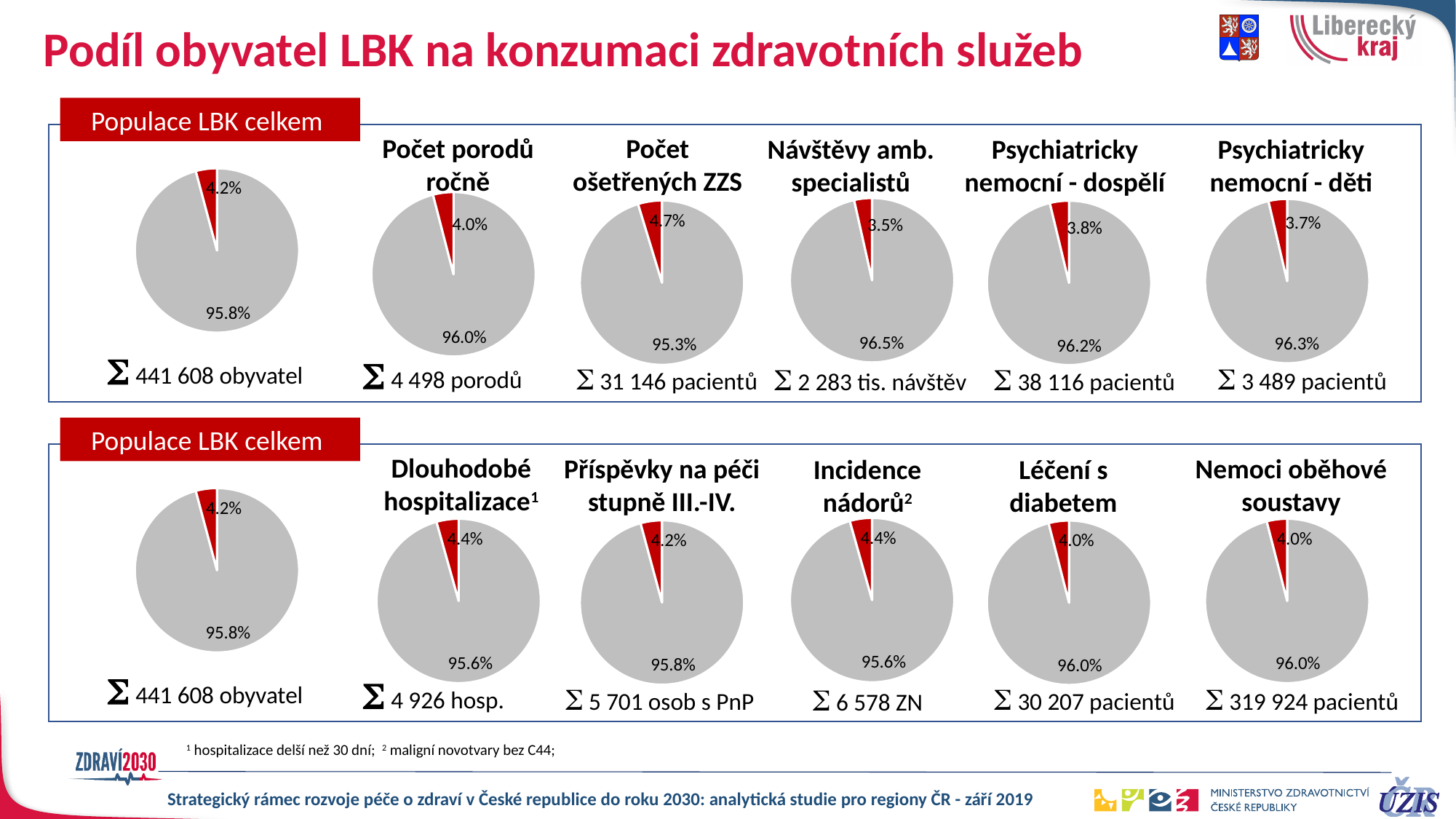
In the pie chart titled "Dlouhodobé hospitalizace", what percentage does the red slice represent? 4.4% Among the pie charts in the top row, which chart has the largest red slice? Počet ošetřených ZZS What colour is the smaller slice in the pie chart titled "Příspěvky na péči stupně III.-IV."? red In the pie chart titled "Počet ošetřených ZZS", what percentage does the red slice represent? 4.7% In the pie chart titled "Návštěvy amb. specialistů", what percentage does the grey slice represent? 96.5% In the pie chart titled "Nemoci oběhové soustavy", what percentage does the grey slice represent? 96.0% What type of chart is used for "Populace LBK celkem"? pie chart Which red slice is larger: the one in the "Incidence nádorů" chart or the one in the "Léčení s diabetem" chart? Incidence nádorů In the pie chart titled "Psychiatricky nemocní - děti", what percentage does the red slice represent? 3.7% How many slices does the pie chart titled "Psychiatricky nemocní - dospělí" have? 2 Among the pie charts in the top row, which chart has the smallest red slice? Návštěvy amb. specialistů What is the difference between the red slice in the "Počet ošetřených ZZS" chart and the red slice in the "Návštěvy amb. specialistů" chart? 1.2%